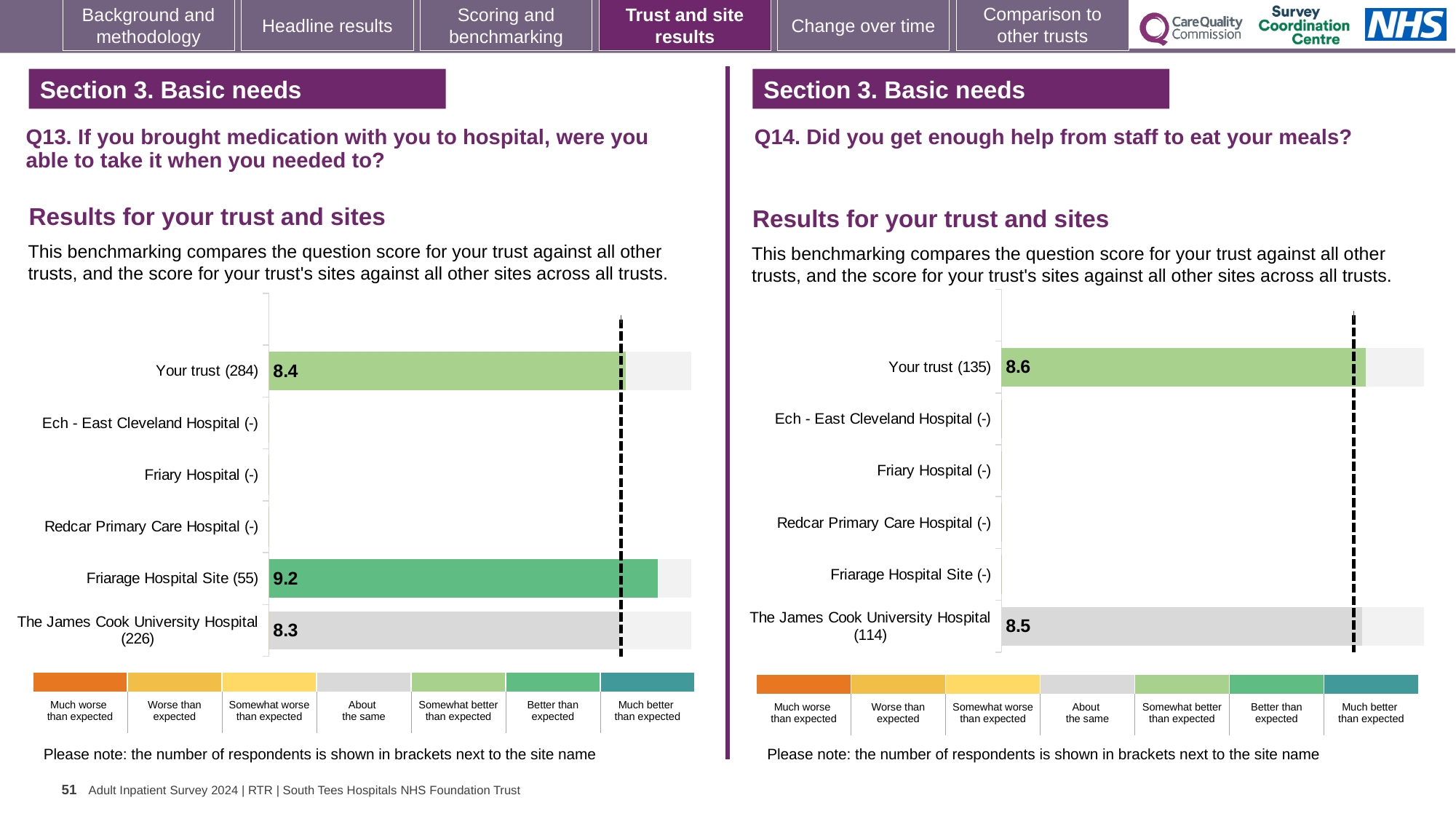
In the Q13 chart on the left, which is larger: the score for Your trust or the score for Friarage Hospital Site? Friarage Hospital Site In the Q13 chart on the left, how many respondents are shown in brackets for Friarage Hospital Site? 55 In the Q14 chart on the right, how many sites have a plotted bar with a score? 2 In the Q13 chart on the left, what is the score for Friarage Hospital Site (55)? 9.2 In the Q14 chart on the right, what is the difference between the Your trust score and The James Cook University Hospital score? 0.1 In the Q13 chart on the left, which site has the highest score? Friarage Hospital Site (55) In the Q13 chart on the left, what is the score for Your trust (284)? 8.4 In the Q14 chart on the right, what is the score for The James Cook University Hospital (114)? 8.5 In the Q13 chart on the left, what is the difference between the Friarage Hospital Site score and The James Cook University Hospital score? 0.9 In the Q13 chart on the left, what is the score for The James Cook University Hospital (226)? 8.3 What kind of chart is used on the left for Q13? Bar chart In the Q14 chart on the right, what is the score for Your trust (135)? 8.6